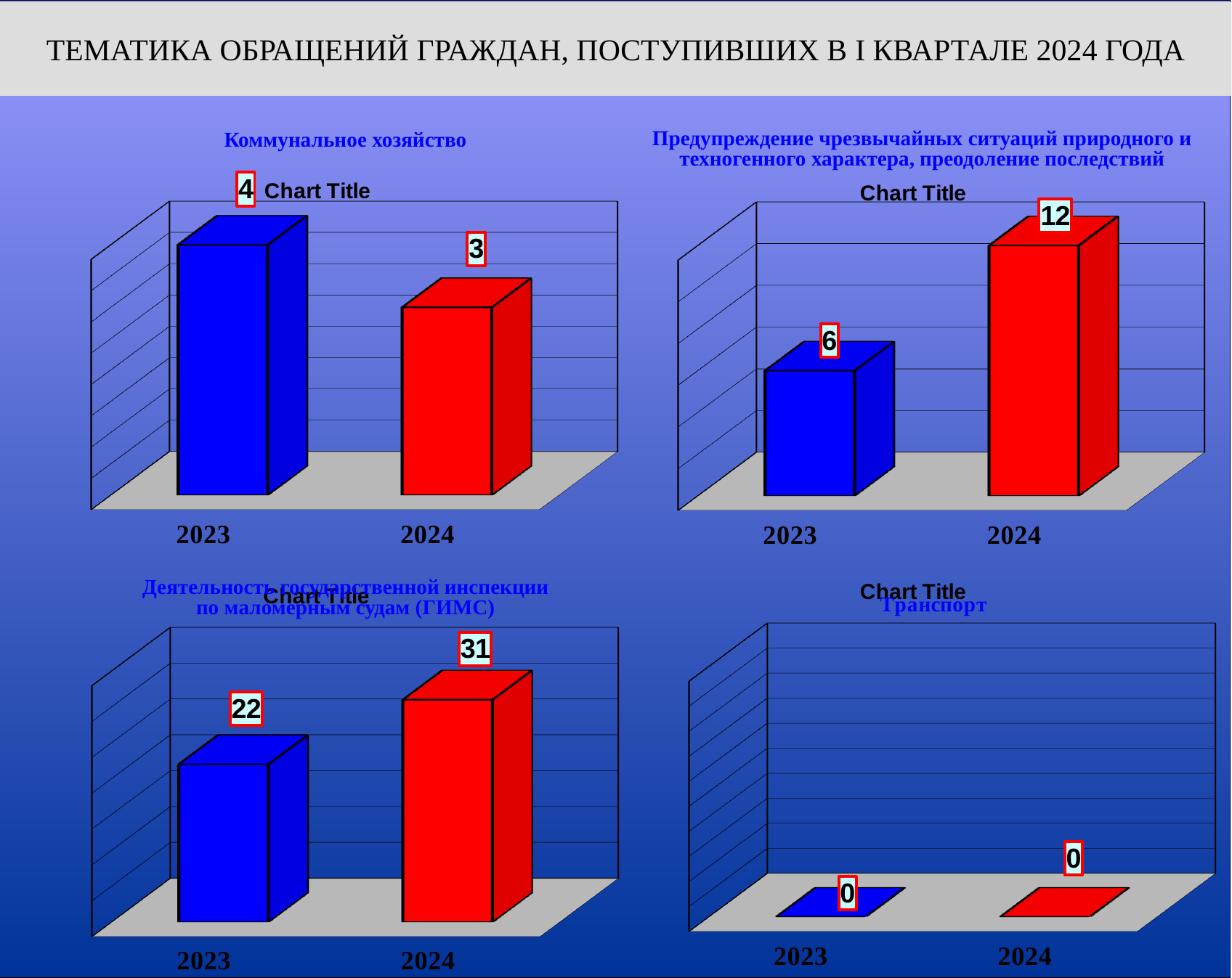
In the chart titled "Транспорт", what is the value for 2024? 0 In the top-right chart ("Предупреждение чрезвычайных ситуаций..."), what is the difference between the 2024 and 2023 values? 6 How many categories (years) are shown on the x axis of the chart titled "Транспорт"? 2 In the chart titled "Коммунальное хозяйство", do the values rise or fall from 2023 to 2024? fall What kind of chart is the chart titled "Коммунальное хозяйство"? bar chart In the top-right chart ("Предупреждение чрезвычайных ситуаций..."), what is the value for 2024? 12 In the chart titled "Коммунальное хозяйство", what is the value for 2023? 4 In the chart titled "Деятельность государственной инспекции по маломерным судам (ГИМС)", what is the value for 2023? 22 In the chart titled "Коммунальное хозяйство", what is the value for 2024? 3 In the chart titled "Деятельность государственной инспекции по маломерным судам (ГИМС)", what is the value for 2024? 31 In the top-right chart ("Предупреждение чрезвычайных ситуаций..."), which year has the higher value? 2024 In the chart titled "Деятельность государственной инспекции по маломерным судам (ГИМС)", by how much does the 2024 value exceed the 2023 value? 9